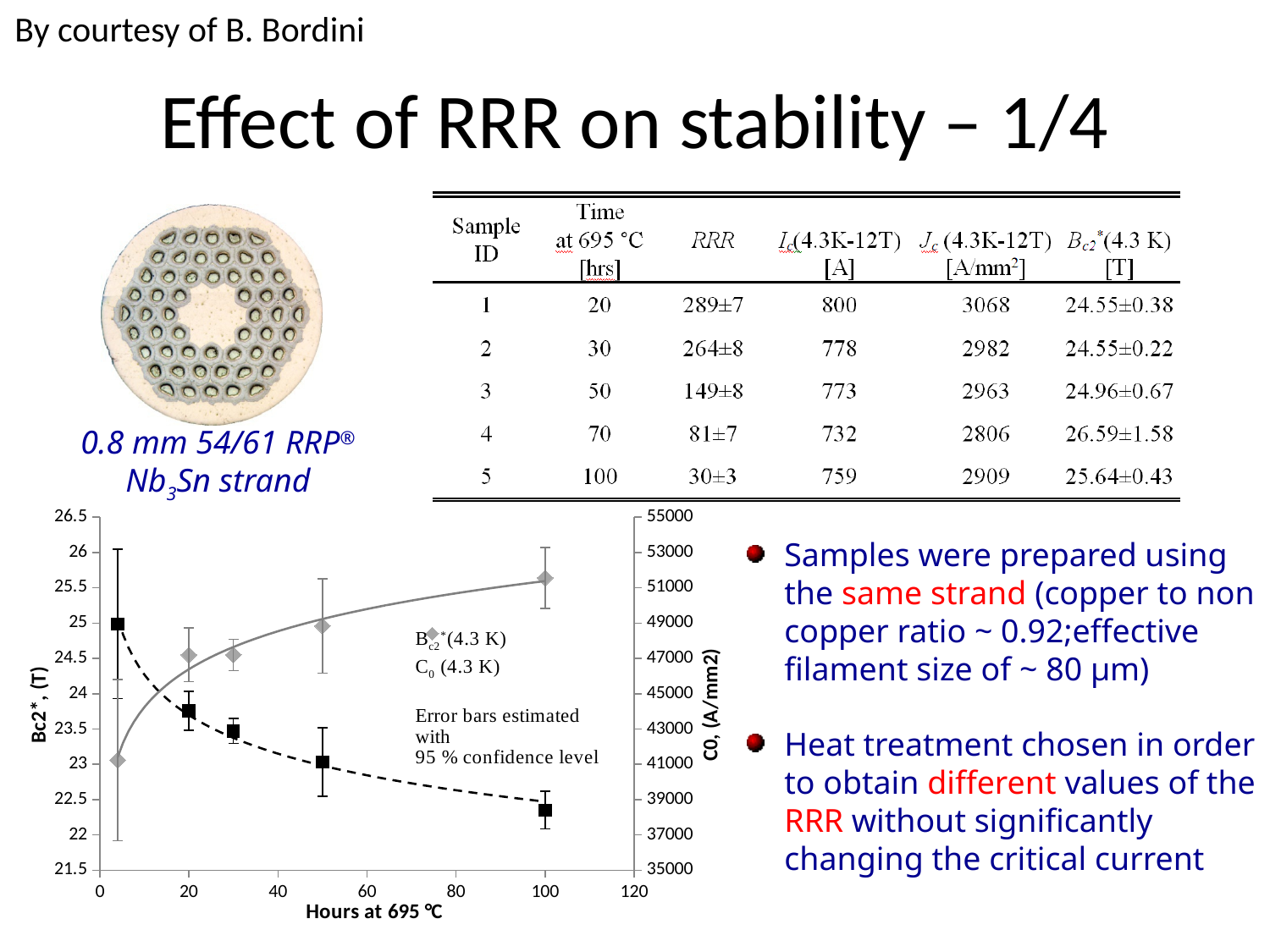
How many series does the chart's legend list? 2 Which is larger, the C0 (4.3 K) value at 20 hours or at 100 hours? 20 hours Is the Bc2*(4.3 K) value at 100 hours greater or less than 25? greater What is the label of the chart's x axis? Hours at 695 ℃ Which is larger, the Bc2*(4.3 K) value at 100 hours or at 20 hours? 100 hours Is the Bc2*(4.3 K) value at 20 hours greater or less than 24? greater Does the C0 (4.3 K) series rise or fall as the hours at 695 °C increase? fall What kind of chart is shown at the bottom left of the slide? scatter chart Does the Bc2*(4.3 K) series rise or fall as the hours at 695 °C increase? rise At which number of hours at 695 °C is the Bc2*(4.3 K) value highest? 100 How many data points are plotted for the Bc2*(4.3 K) series? 5 Is the C0 (4.3 K) value at 100 hours greater or less than 41000? less